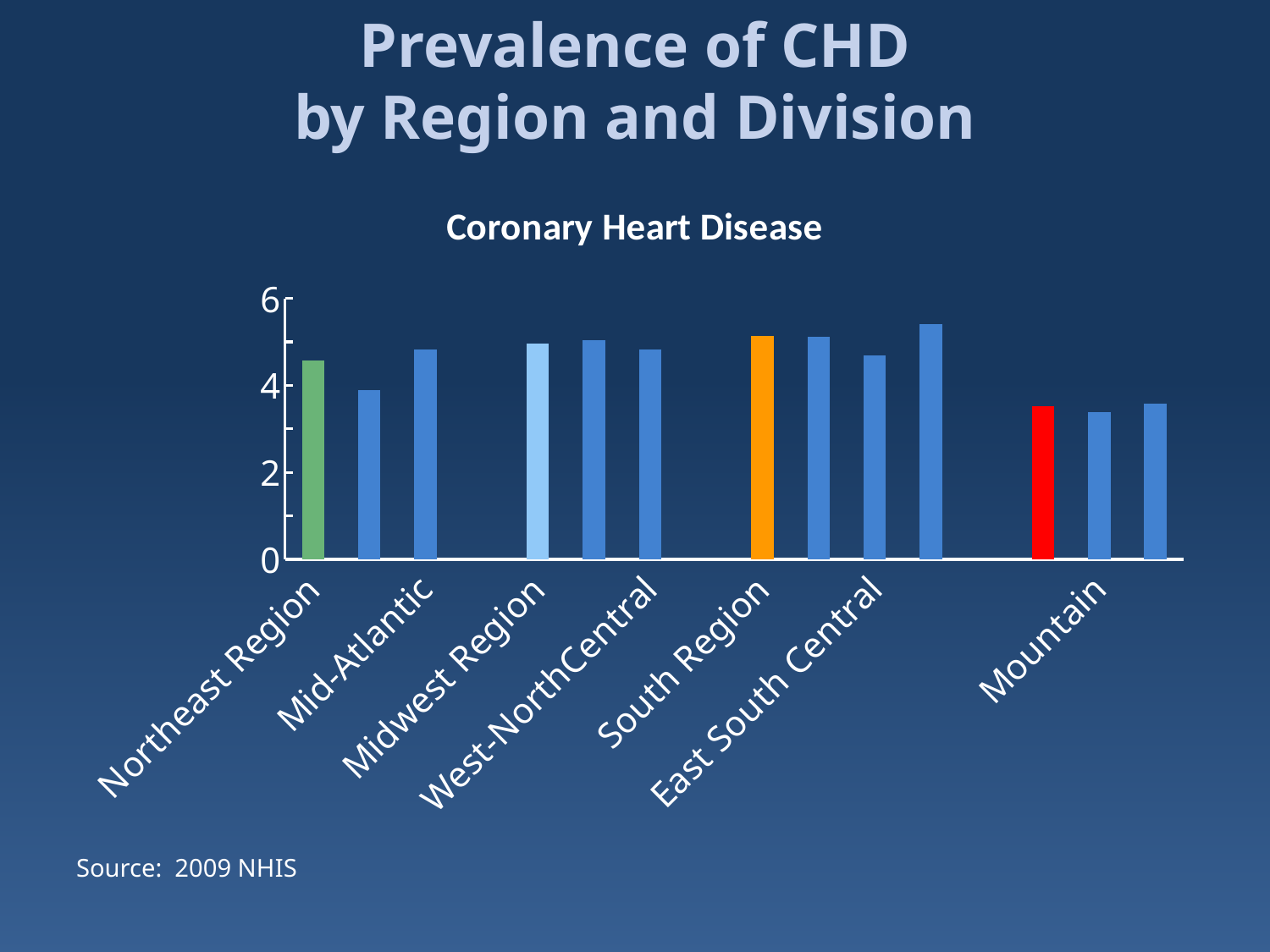
Is the value for South Region greater or less than 4? greater How many bars are plotted in the chart? 13 What colour is the bar for South Region? orange Is the value for Mountain greater or less than 4? less Is the value for Mid-Atlantic greater or less than 6? less Which has the larger value, South Region or Mountain? South Region Which has the larger value, Mountain or Northeast Region? Northeast Region What is the title of the chart? Coronary Heart Disease What kind of chart is shown on the slide? bar chart Among the labeled categories, which has the lowest value? Mountain